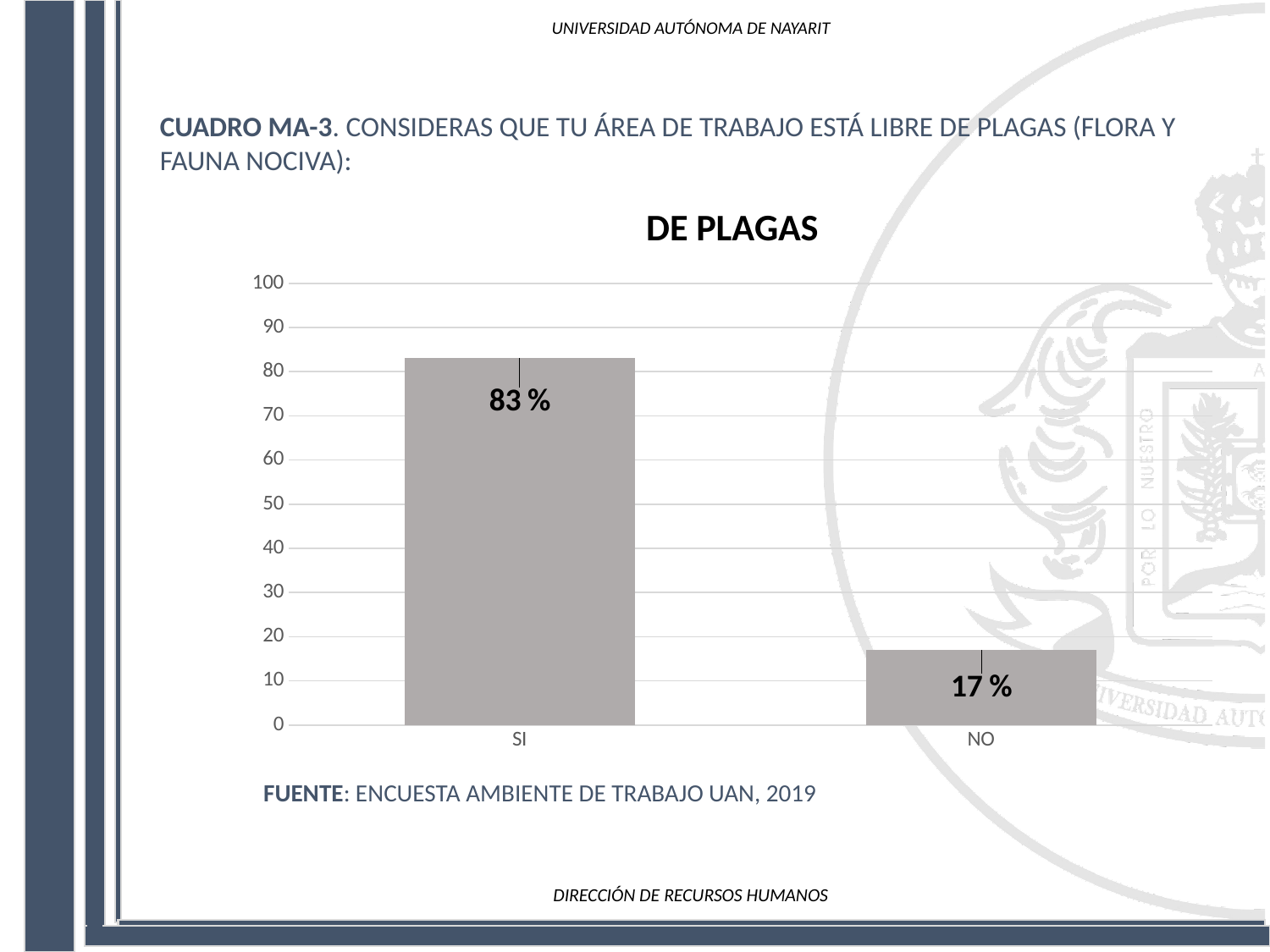
What is the value for NO? 17 % How many categories are shown on the x axis? 2 Is the value for SI greater or less than 80? greater What is the value for SI? 83 % What kind of chart is shown on the slide? bar chart Which category has the highest value? SI What is the difference between the values for SI and NO? 66 % Is the value for NO greater or less than 20? less Which is larger, the value for SI or the value for NO? SI What is the maximum value shown on the vertical axis? 100 What is the title of the chart? DE PLAGAS Which category has the lowest value? NO